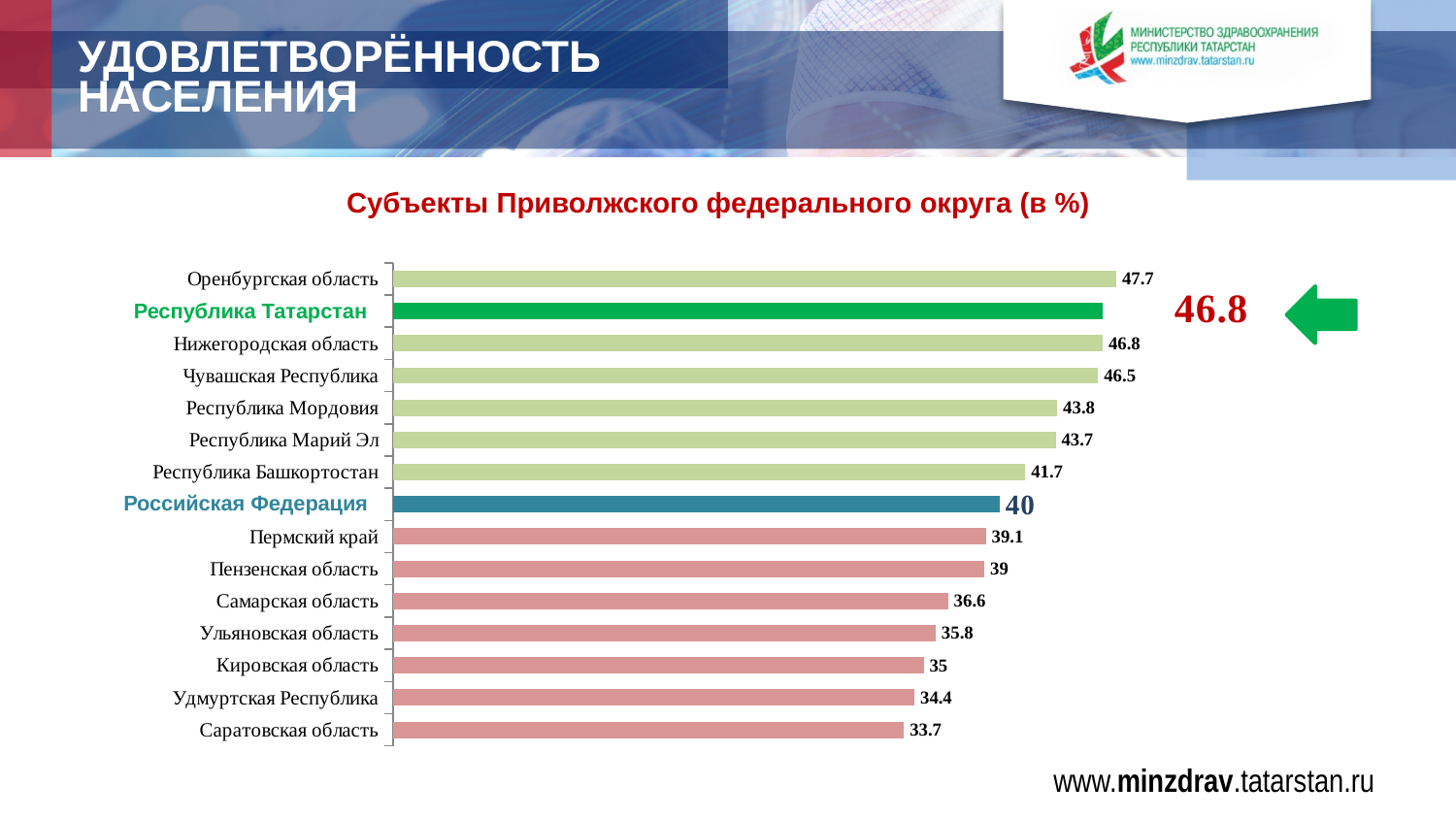
What is the difference between the values for Республика Татарстан and Российская Федерация? 6.8 What is the value for Республика Татарстан? 46.8 Which category has the highest value? Оренбургская область Which category has the lowest value? Саратовская область What type of chart is shown on the slide? bar chart How many categories are shown in the chart? 15 What is the value for Российская Федерация? 40 Which is larger, the value for Республика Мордовия or the value for Пермский край? Республика Мордовия What is the difference between the values for Оренбургская область and Саратовская область? 14 What is the value for Саратовская область? 33.7 What is the value for Оренбургская область? 47.7 What is the title of the chart? Субъекты Приволжского федерального округа (в %)